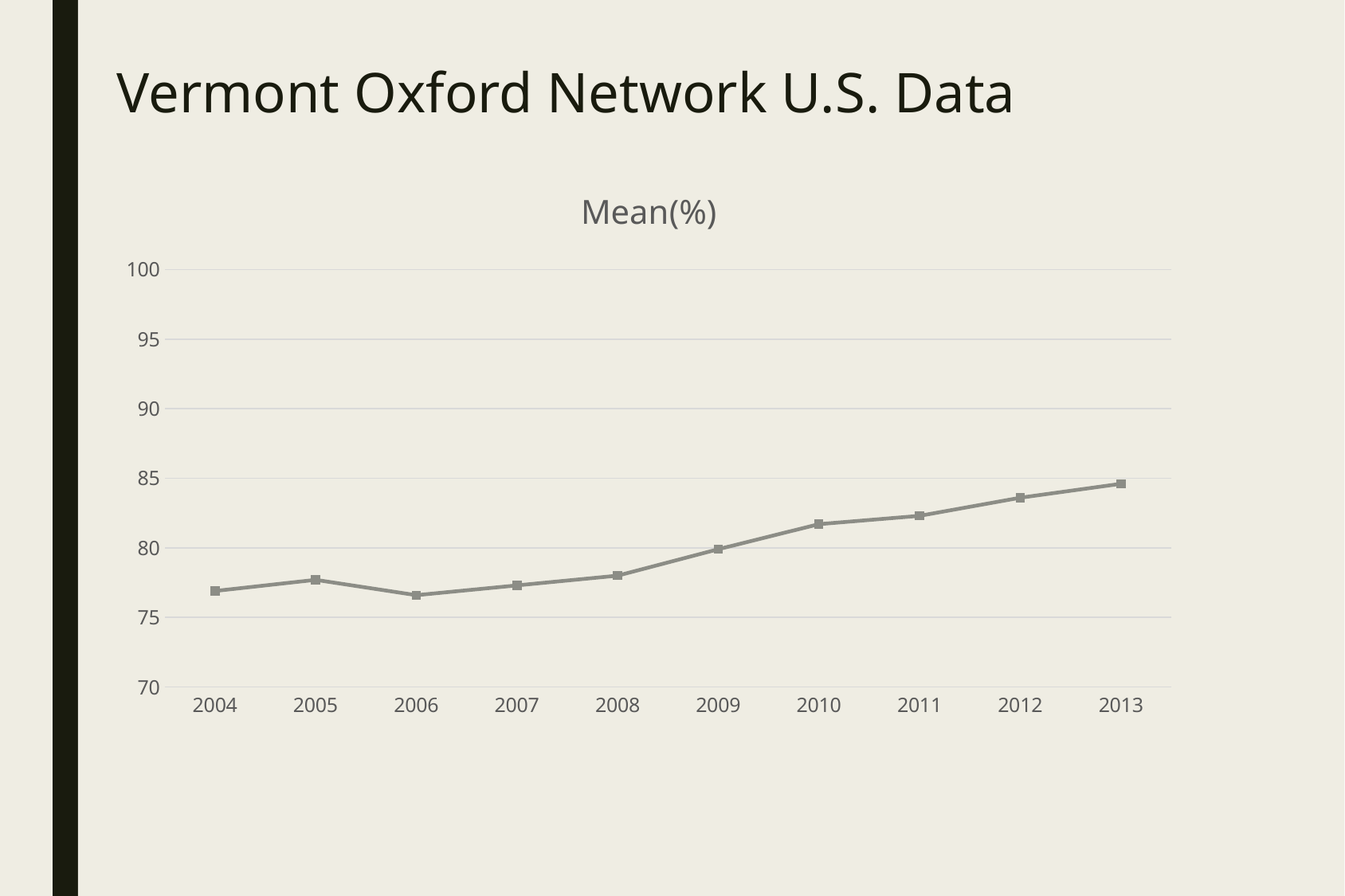
Is the value for 2011 greater or less than 80? greater Which is larger, the value for 2004 or the value for 2013? 2013 What kind of chart is shown on the slide? line chart Is the value for 2013 greater or less than 80? greater What is the title of the chart? Mean(%) Which year has the highest value? 2013 Is the value for 2006 greater or less than 80? less Which is larger, the value for 2008 or the value for 2012? 2012 How many years are plotted on the x axis? 10 Do the values generally rise or fall from 2004 to 2013? rise